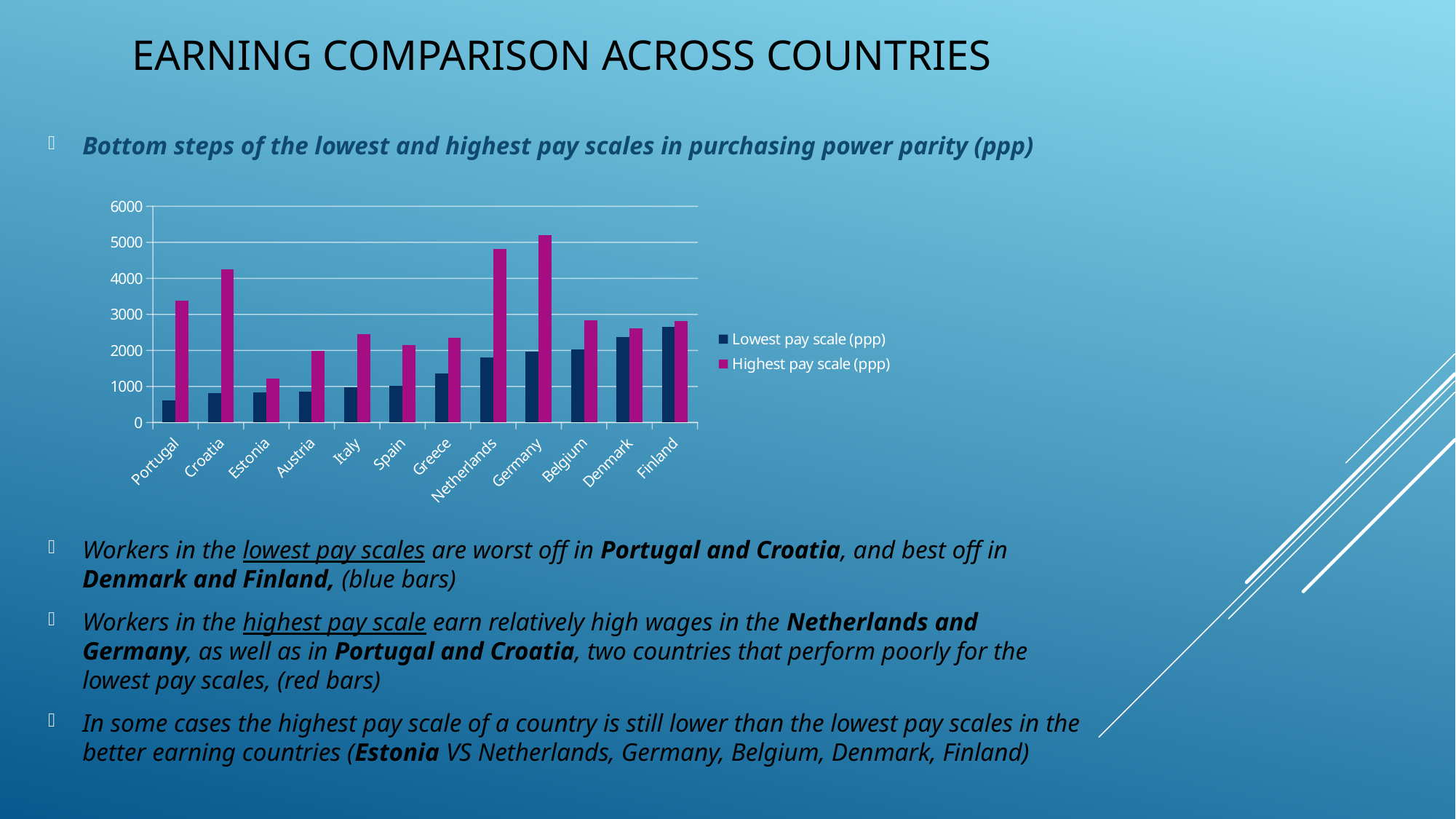
Is the Highest pay scale (ppp) value for Netherlands greater or less than 5000? less Is the Highest pay scale (ppp) value for Germany greater or less than 5000? greater How many series does the chart's legend list? 2 Which country has the highest value for the Highest pay scale (ppp) series? Germany Which is larger, the Highest pay scale (ppp) value for Croatia or for Portugal? Croatia Which country has the lowest value for the Lowest pay scale (ppp) series? Portugal Is the Lowest pay scale (ppp) value for Portugal greater or less than 1000? less Which country has the lowest value for the Highest pay scale (ppp) series? Estonia What kind of chart is shown on the slide? bar chart Do the Lowest pay scale (ppp) values generally rise or fall from Portugal to Finland along the x axis? rise How many countries are shown on the x axis of the chart? 12 Which country has the highest value for the Lowest pay scale (ppp) series? Finland